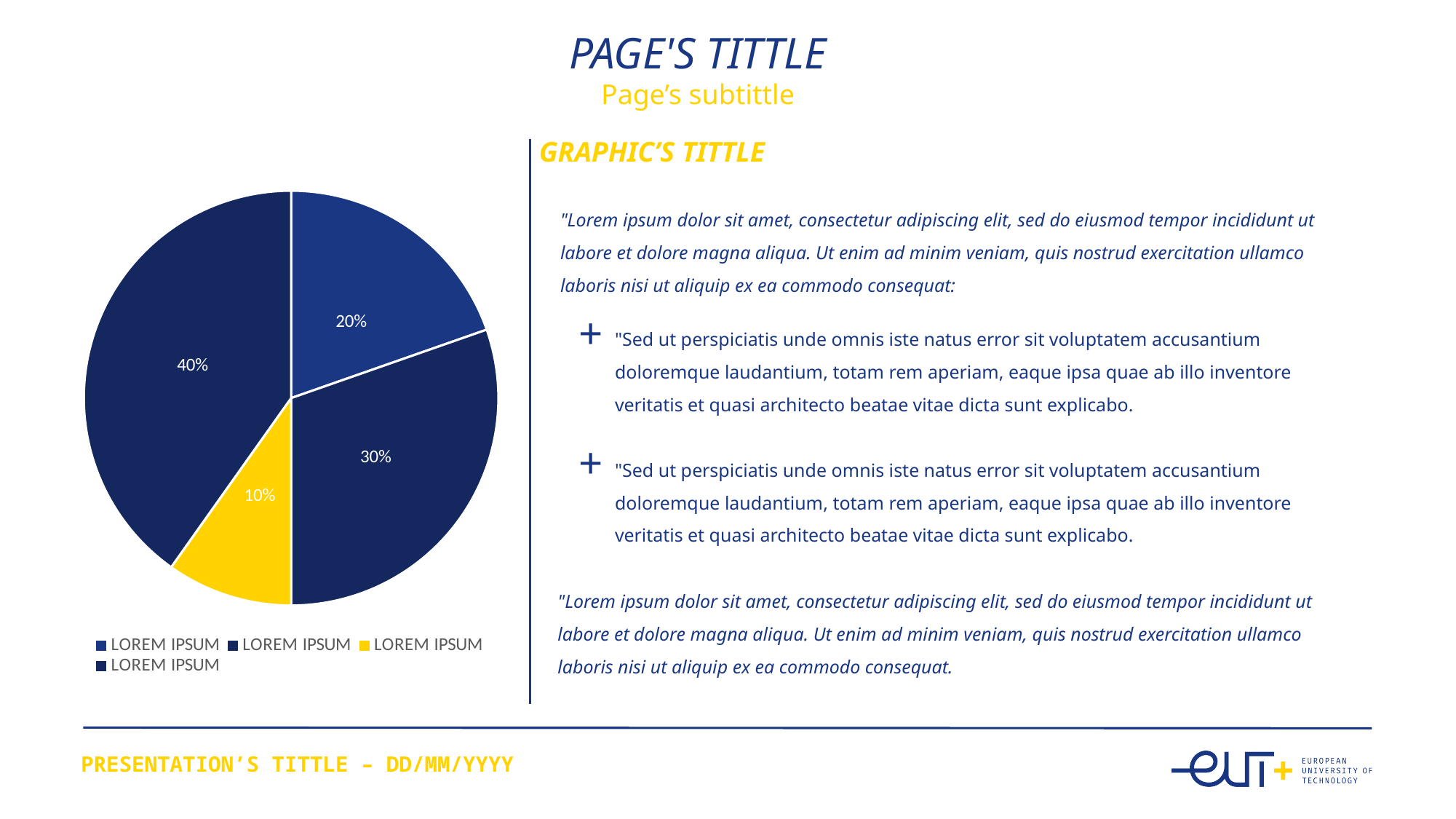
What is the title shown above the text next to the pie chart? GRAPHIC'S TITTLE What is the value of the smallest slice in the pie chart? 10% What is the difference between the largest and smallest slices in the pie chart? 30% Which is larger in the pie chart: the yellow slice or the slice labelled 20%? the slice labelled 20% What is the combined share of the two slices labelled 30% and 40% in the pie chart? 70% What percentage is shown on the yellow slice of the pie chart? 10% What kind of chart is shown on the slide? pie chart What colour is the smallest slice of the pie chart? yellow How many entries does the pie chart's legend list? 4 How many slices does the pie chart have? 4 What is the difference between the 30% slice and the 20% slice in the pie chart? 10% What is the value of the largest slice in the pie chart? 40%